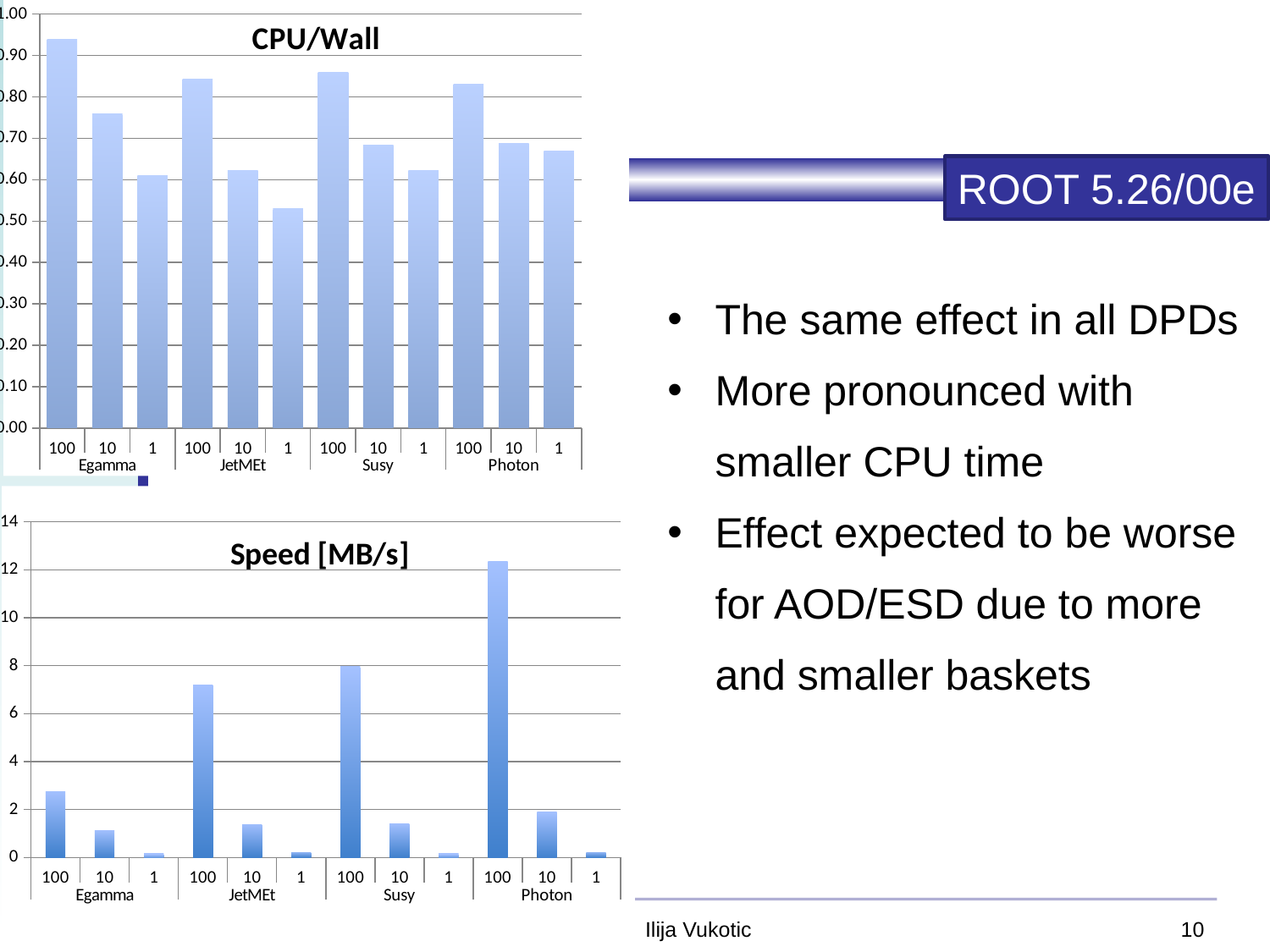
In the Speed [MB/s] chart, which bar is the highest? Photon 100 In the CPU/Wall chart, do the values for Egamma rise or fall going from 100 to 10 to 1? fall In the CPU/Wall chart, which bar is the highest? Egamma 100 What kind of chart is the CPU/Wall chart at the top of the slide? bar chart How many bars are plotted in the Speed [MB/s] chart? 12 In the CPU/Wall chart, is the value for JetMEt 1 greater or less than 0.60? less In the Speed [MB/s] chart, which is larger: Susy 100 or Egamma 100? Susy 100 In the Speed [MB/s] chart, is the value for JetMEt 100 greater or less than 8? less In the Speed [MB/s] chart, is the value for Photon 100 greater or less than 12? greater In the CPU/Wall chart, which bar is the lowest? JetMEt 1 What is the title of the bottom chart on the slide? Speed [MB/s]